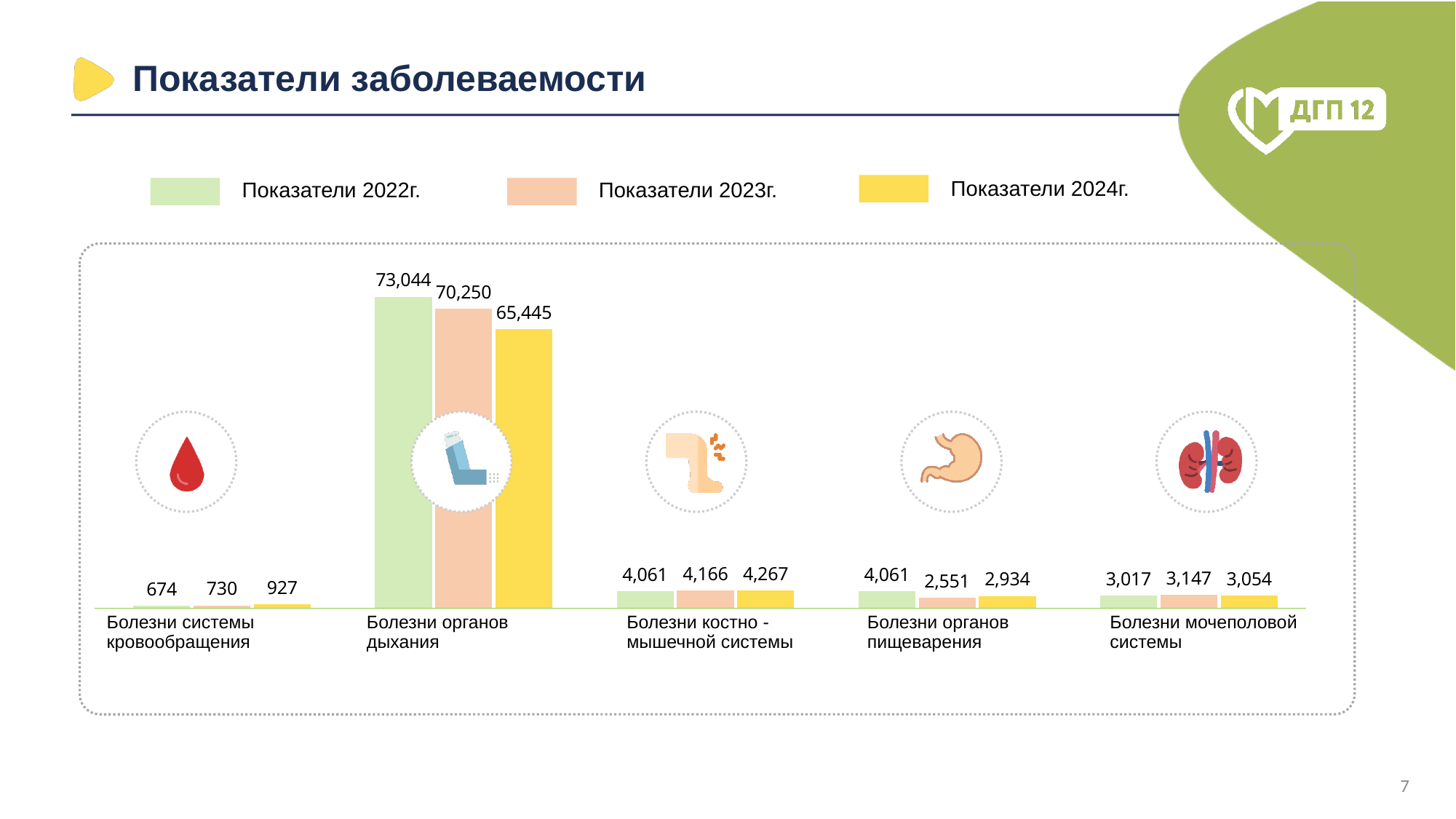
Which is larger for Болезни органов пищеварения: the 2022 value or the 2023 value? 2022 value (4,061) Do the values for Болезни костно-мышечной системы rise or fall from 2022 to 2024? rise What is the 2022 value (Показатели 2022г.) for Болезни системы кровообращения? 674 Which legend entry is shown in yellow? Показатели 2024г. How many series does the legend list? 3 What type of chart is shown on the slide? bar chart What is the difference between the 2022 and 2024 values for Болезни органов дыхания? 7,599 Which category has the lowest value in 2024 (Показатели 2024г.)? Болезни системы кровообращения What is the 2024 value (Показатели 2024г.) for Болезни органов дыхания? 65,445 How many disease categories are shown on the x axis? 5 Which category has the highest value in 2022 (Показатели 2022г.)? Болезни органов дыхания What is the 2023 value (Показатели 2023г.) for Болезни мочеполовой системы? 3,147